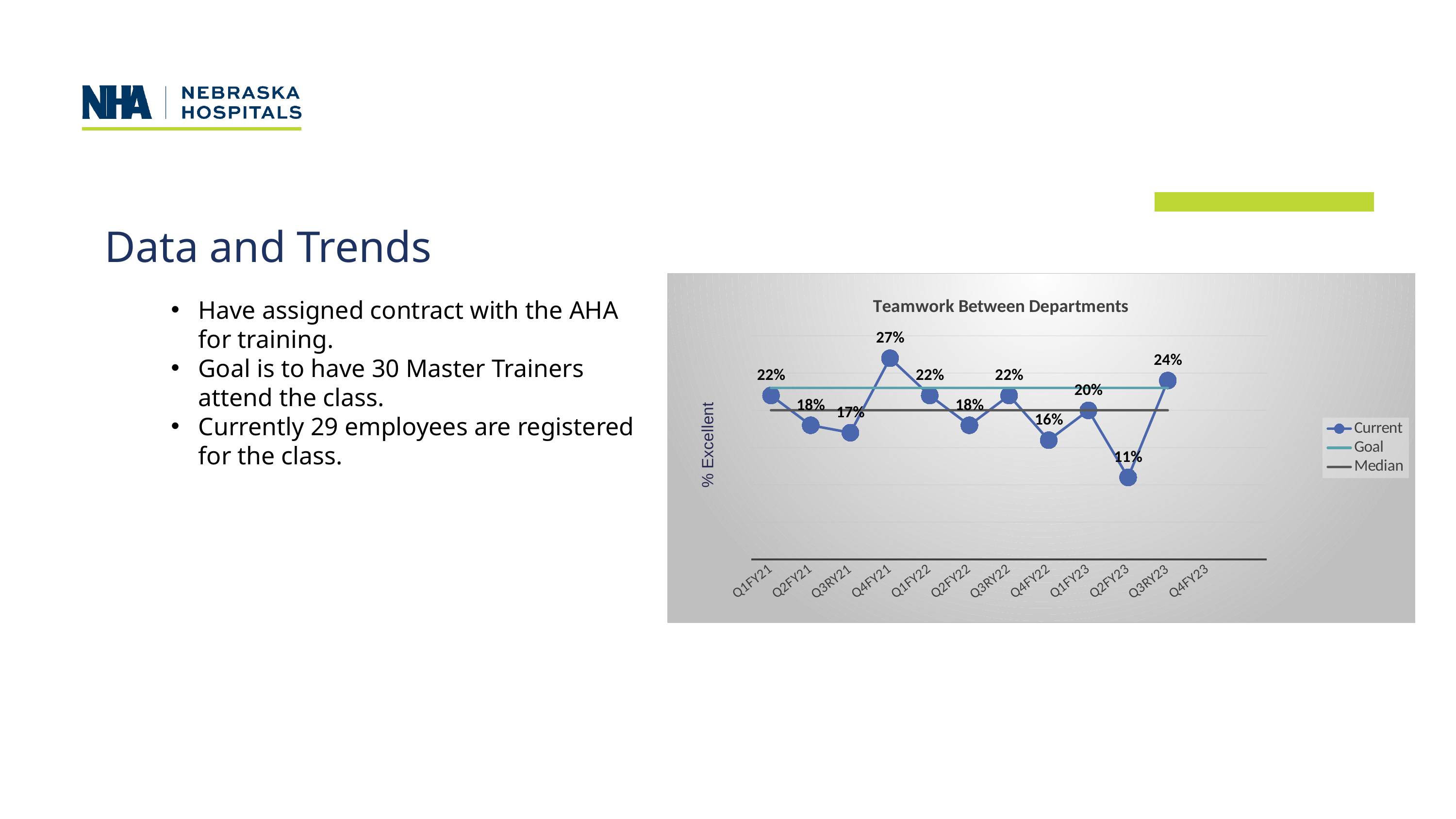
Which quarter has the lowest Current value? Q2FY23 What is the label on the vertical axis? % Excellent Which quarter has the highest Current value? Q4FY21 What is the Current value for Q3RY23? 24% What is the title of the chart? Teamwork Between Departments What is the Current value for Q2FY23? 11% What is the Current value for Q4FY21? 27% What type of chart is shown on the slide? line chart How many quarters are labelled on the x axis? 12 What is the difference between the Current values for Q4FY21 and Q2FY23? 16% How many series does the chart legend list? 3 Which is larger, the Current value for Q1FY23 or for Q4FY22? Q1FY23